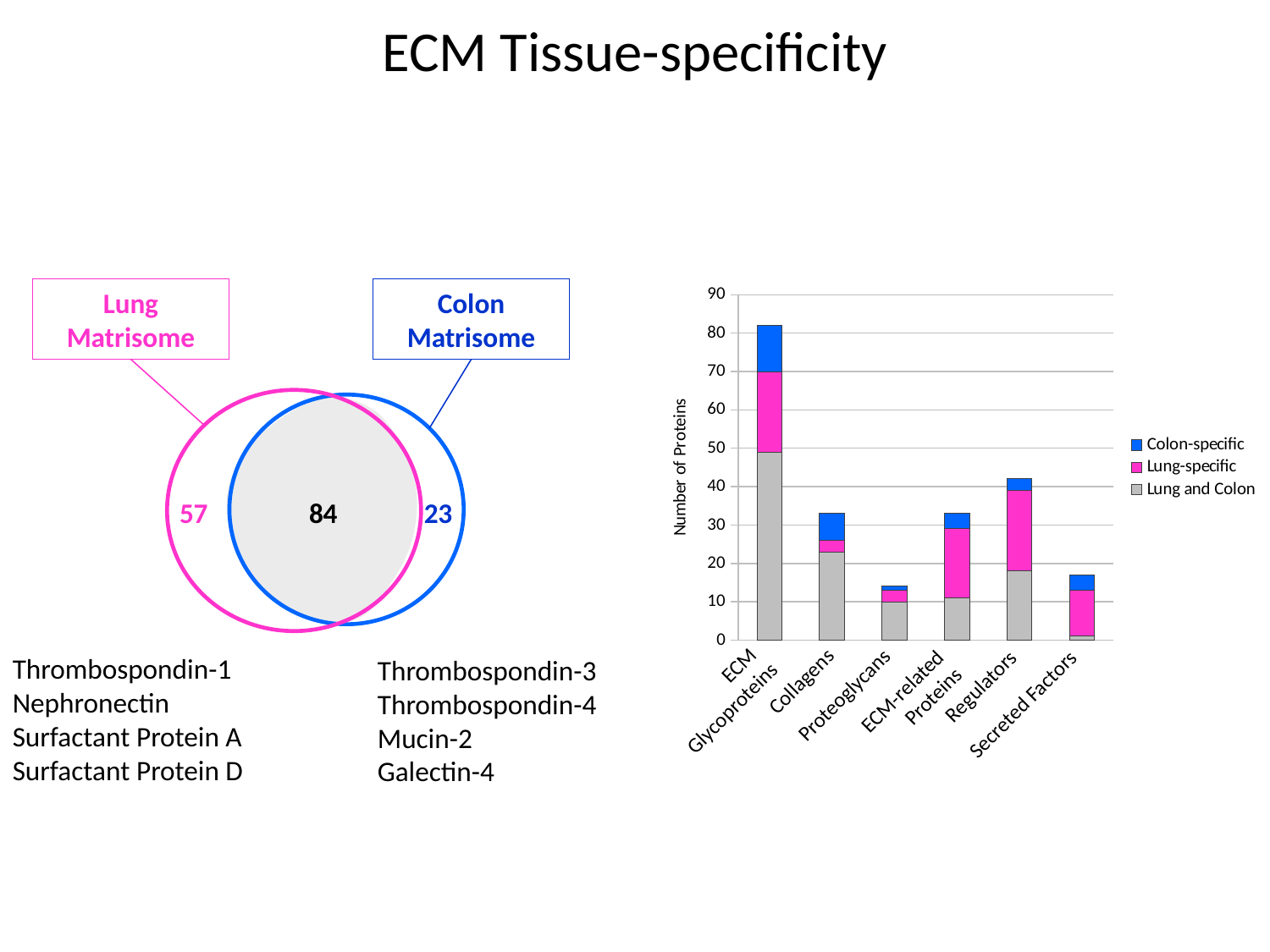
In the bar chart on the right, which series is shown in grey according to the legend? Lung and Colon In the bar chart on the right, what is the label of the y axis? Number of Proteins In the bar chart on the right, how many categories are shown on the x axis? 6 In the bar chart on the right, which stacked bar is taller, Regulators or Collagens? Regulators In the bar chart on the right, what kind of chart is it? bar chart In the bar chart on the right, how many series does the legend list? 3 In the Venn diagram on the left, how many proteins are in the overlap between the Lung Matrisome and the Colon Matrisome? 84 In the bar chart on the right, is the total for ECM Glycoproteins greater or less than 70? greater In the bar chart on the right, is the total for Collagens greater or less than 40? less In the bar chart on the right, which category has the tallest stacked bar? ECM Glycoproteins In the bar chart on the right, is the total for Proteoglycans greater or less than 20? less